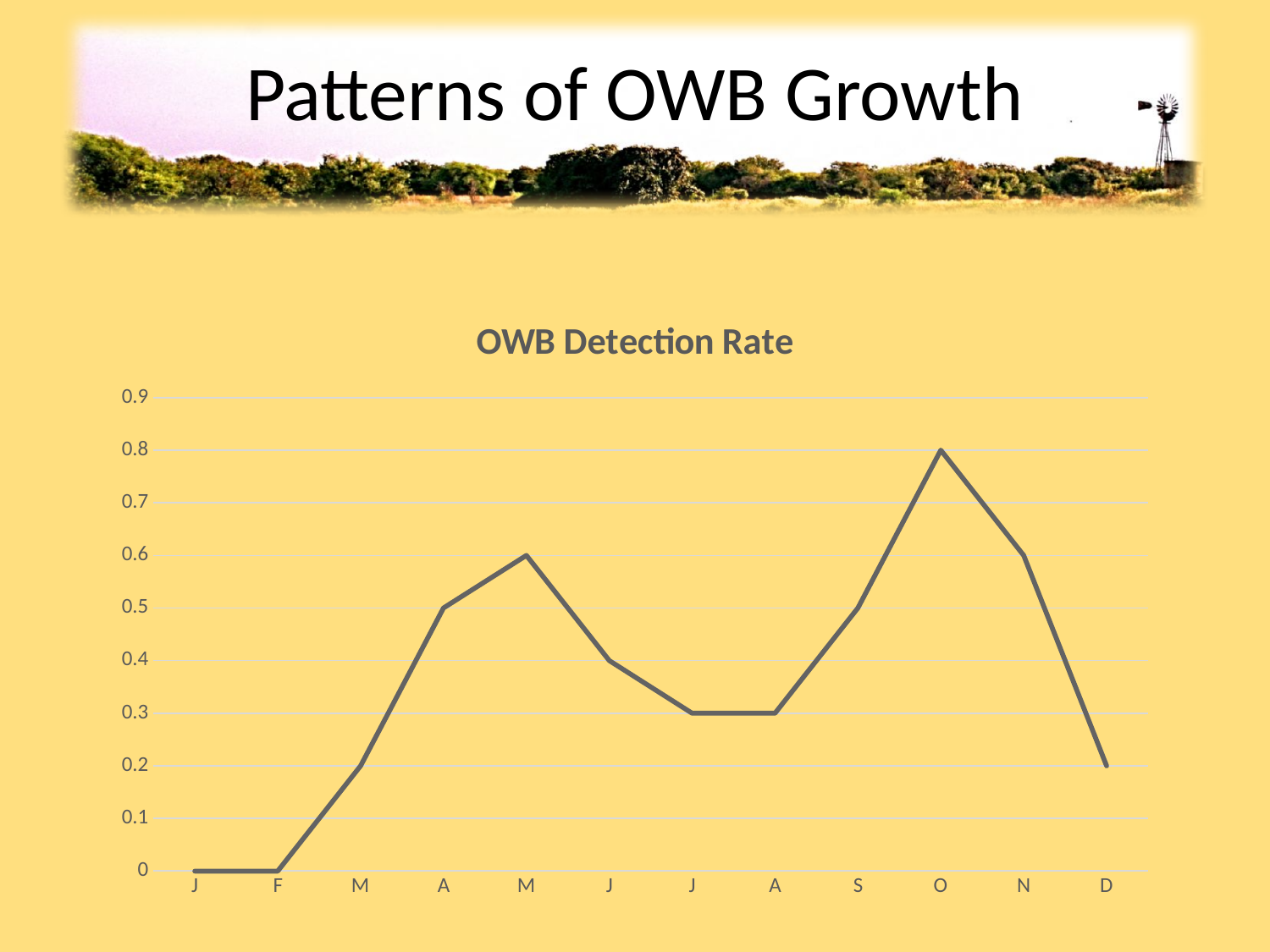
How many points are plotted along the x axis of the OWB Detection Rate chart? 12 Does the OWB Detection Rate rise or fall from the point labelled O to the point labelled D? fall What is the OWB Detection Rate value at the point labelled F? 0 What is the OWB Detection Rate value at the point labelled D? 0.2 What kind of chart is shown on the slide? line chart Which x-axis label has the highest OWB Detection Rate? O Which has a higher OWB Detection Rate, the point labelled S or the point labelled D? S What is the OWB Detection Rate value at the point labelled N? 0.6 What is the difference between the OWB Detection Rate at O and at N? 0.2 What is the title of the chart? OWB Detection Rate What is the OWB Detection Rate value at the point labelled S? 0.5 What is the OWB Detection Rate value at the point labelled O? 0.8